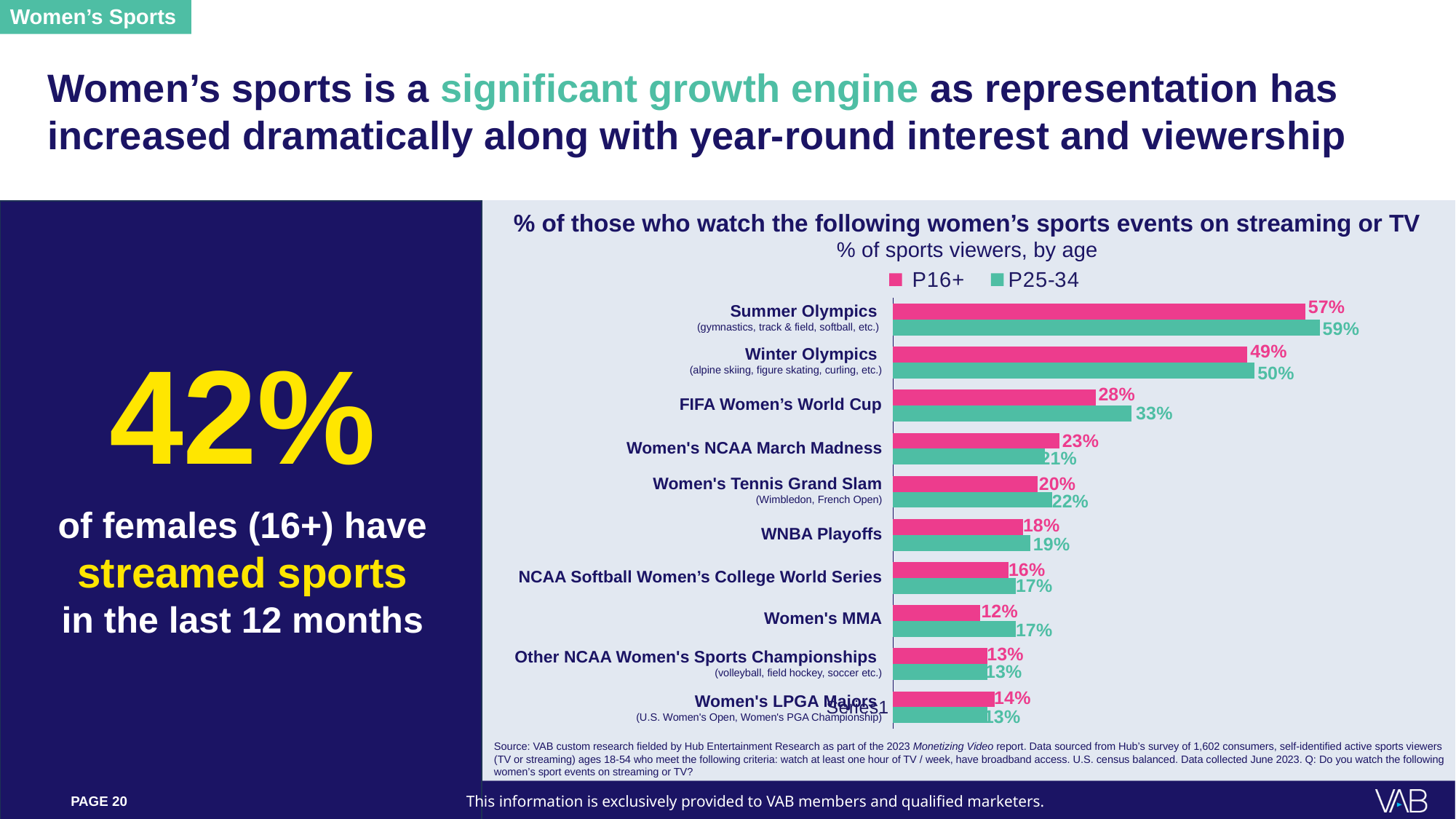
How many women's sports events are listed in the chart? 10 Which event has the lowest P16+ value? Women's MMA What is the difference between the P16+ values for the Summer Olympics and the Winter Olympics? 8 percentage points How many series does the legend list? 2 What percentage of P16+ sports viewers watch the Summer Olympics? 57% Which event has the highest P25-34 value? Summer Olympics For Women's NCAA March Madness, which is larger: the P16+ value or the P25-34 value? P16+ What kind of chart is shown on the slide? Bar chart Which colour represents the P25-34 series in the chart? Green What is the difference between the P25-34 and P16+ values for the FIFA Women's World Cup? 5 percentage points What is the P16+ value for Women's MMA? 12% What percentage of P25-34 sports viewers watch the FIFA Women's World Cup? 33%